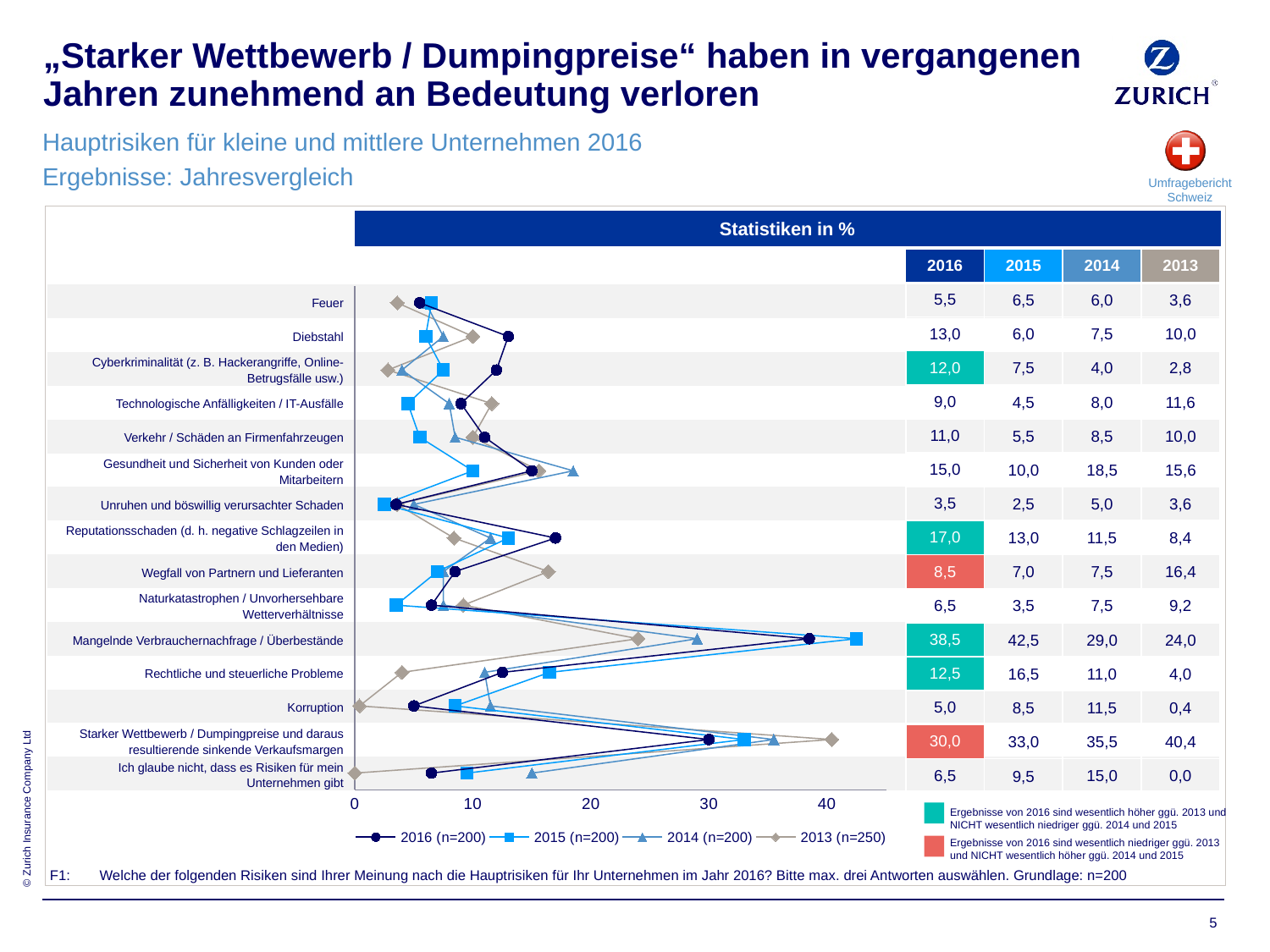
What is the 2016 value for "Starker Wettbewerb / Dumpingpreise und daraus resultierende sinkende Verkaufsmargen"? 30,0 What is the 2014 value for "Gesundheit und Sicherheit von Kunden oder Mitarbeitern"? 18,5 What kind of chart is shown on the slide? Line chart Is the 2014 value for "Starker Wettbewerb / Dumpingpreise und daraus resultierende sinkende Verkaufsmargen" greater or less than 30? greater Which risk has the lowest value in the 2013 series? Ich glaube nicht, dass es Risiken für mein Unternehmen gibt From 2013 to 2016, does the value for "Starker Wettbewerb / Dumpingpreise und daraus resultierende sinkende Verkaufsmargen" rise or fall? Fall What is the 2013 value for "Mangelnde Verbrauchernachfrage / Überbestände"? 24,0 How many series does the legend list? 4 Which risk has the highest value in the 2016 series? Mangelnde Verbrauchernachfrage / Überbestände How many risk categories are plotted in the chart? 15 What is the difference between the 2015 and 2016 values for "Mangelnde Verbrauchernachfrage / Überbestände"? 4,0 Which is larger for "Diebstahl": the 2016 value or the 2015 value? 2016